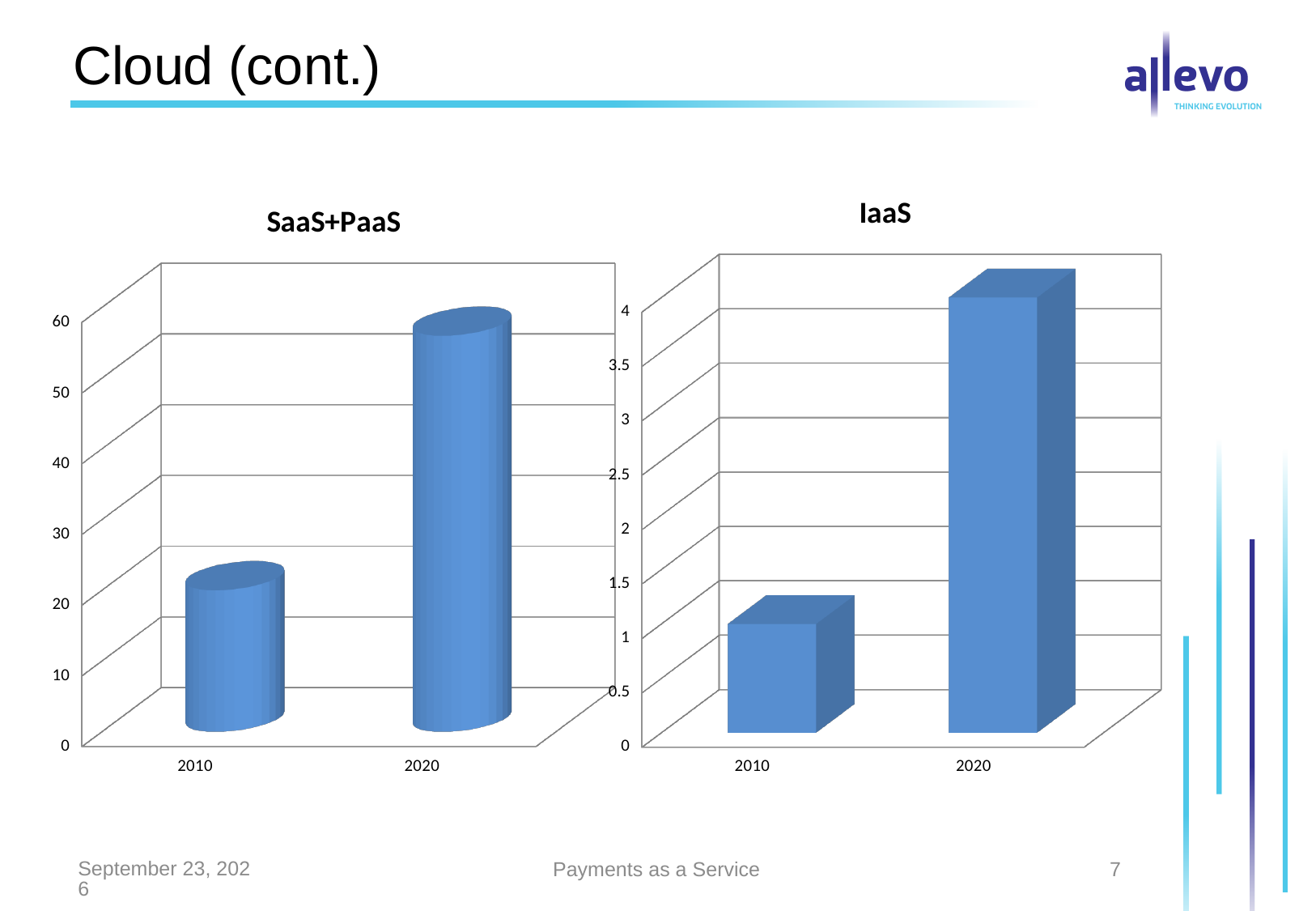
In the SaaS+PaaS chart, is the value for 2010 greater or less than 40? less In the IaaS chart, is the value for 2010 greater or less than 2? less In the SaaS+PaaS chart, which year has the higher value? 2020 What is the title of the chart on the right side of the slide? IaaS In the SaaS+PaaS chart, do the values rise or fall from 2010 to 2020? rise In the IaaS chart, is the value for 2010 larger or smaller than the value for 2020? smaller What kind of chart is the SaaS+PaaS chart? bar chart How many categories are shown on the x axis of the IaaS chart? 2 In the IaaS chart, which year has the lower value? 2010 In the SaaS+PaaS chart, is the value for 2020 greater or less than 40? greater What kind of chart is the IaaS chart? bar chart